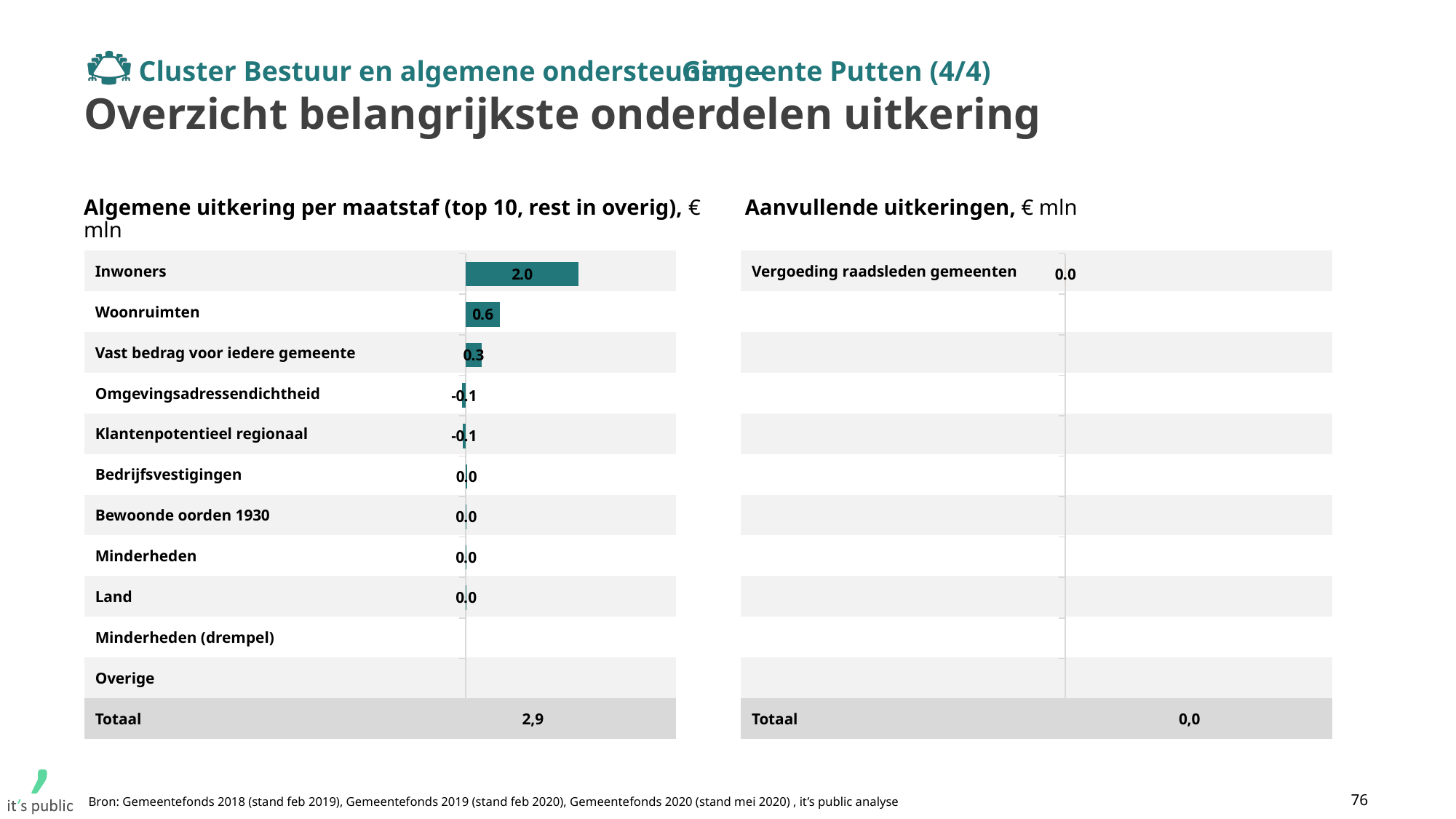
In the chart 'Algemene uitkering per maatstaf', what is the value for Vast bedrag voor iedere gemeente? 0.3 In the chart 'Aanvullende uitkeringen', what is the value for Vergoeding raadsleden gemeenten? 0.0 In the chart 'Algemene uitkering per maatstaf', what is the Totaal value shown at the bottom? 2,9 In the chart 'Algemene uitkering per maatstaf', what is the difference between the values for Inwoners and Woonruimten? 1.4 In the chart 'Algemene uitkering per maatstaf', what is the value for Woonruimten? 0.6 In the chart 'Algemene uitkering per maatstaf', which category has the highest value? Inwoners What kind of chart is the left chart 'Algemene uitkering per maatstaf'? Bar chart In the chart 'Aanvullende uitkeringen', what is the Totaal value shown at the bottom? 0,0 What unit is stated in the title of the right chart 'Aanvullende uitkeringen'? € mln In the chart 'Algemene uitkering per maatstaf', what is the value for Omgevingsadressendichtheid? -0.1 In the chart 'Algemene uitkering per maatstaf', which is larger: Woonruimten or Vast bedrag voor iedere gemeente? Woonruimten In the chart 'Algemene uitkering per maatstaf', what is the value for Inwoners? 2.0